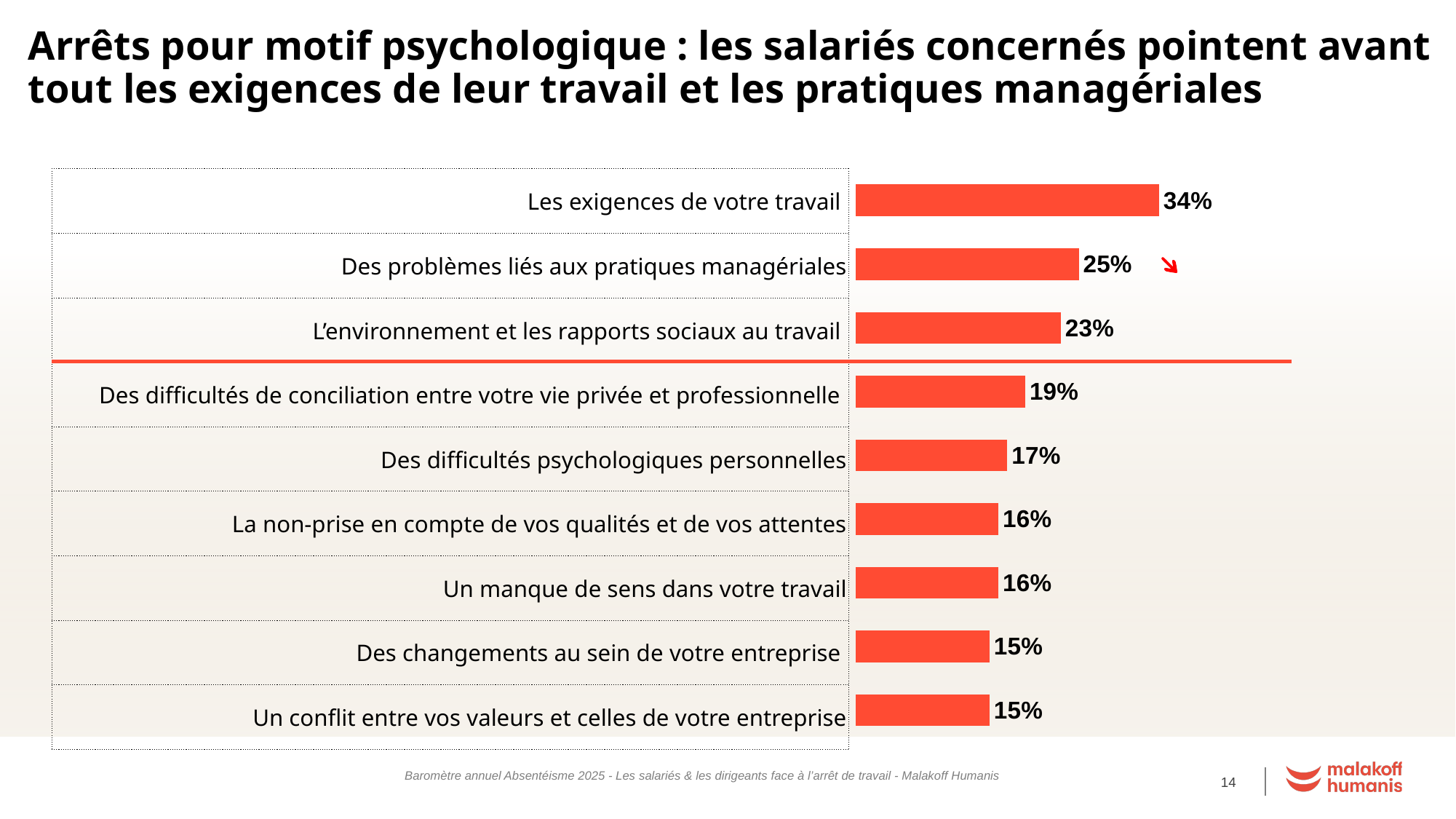
Which is larger: "L'environnement et les rapports sociaux au travail" or "Des difficultés de conciliation entre votre vie privée et professionnelle"? L'environnement et les rapports sociaux au travail What is the value for "Des difficultés de conciliation entre votre vie privée et professionnelle"? 19% What is the value for "Des difficultés psychologiques personnelles"? 17% What colour are the bars in the chart? Red How many categories are shown in the chart? 9 What is the difference between "L'environnement et les rapports sociaux au travail" and "Des changements au sein de votre entreprise"? 8% What is the difference between "Les exigences de votre travail" and "Des problèmes liés aux pratiques managériales"? 9% Which category has the highest value? Les exigences de votre travail What is the value for "Des problèmes liés aux pratiques managériales"? 25% What is the value for "Les exigences de votre travail"? 34% What kind of chart is shown on the slide? Bar chart What value is shown for "Un conflit entre vos valeurs et celles de votre entreprise"? 15%